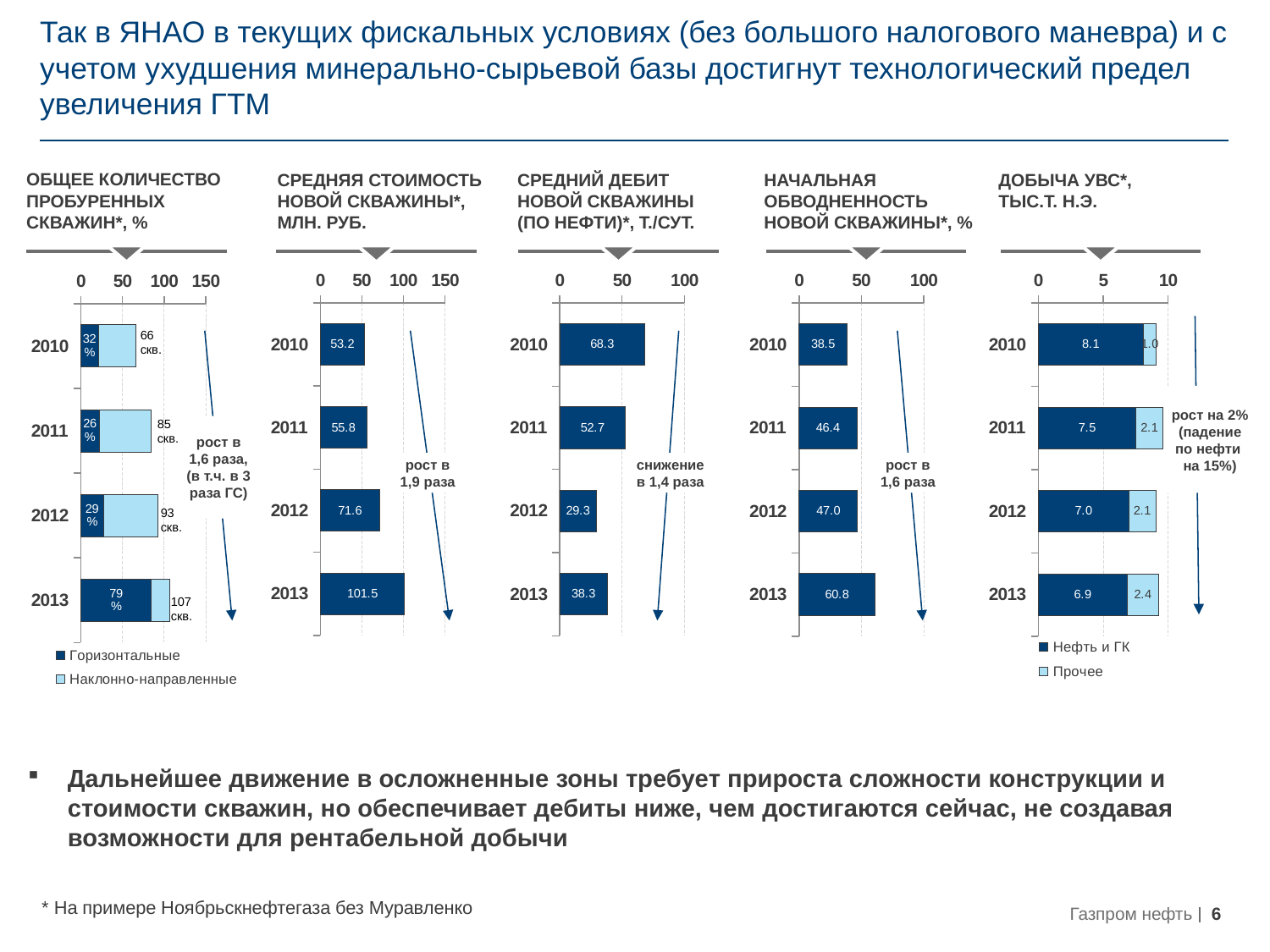
On the chart 'НАЧАЛЬНАЯ ОБВОДНЕННОСТЬ НОВОЙ СКВАЖИНЫ*, %', which year has the highest value? 2013 On the chart 'СРЕДНЯЯ СТОИМОСТЬ НОВОЙ СКВАЖИНЫ*, МЛН. РУБ.', what is the value for 2013? 101.5 What type of chart is 'СРЕДНЯЯ СТОИМОСТЬ НОВОЙ СКВАЖИНЫ*, МЛН. РУБ.'? bar chart On the chart 'СРЕДНИЙ ДЕБИТ НОВОЙ СКВАЖИНЫ (ПО НЕФТИ)*, Т./СУТ.', is the value for 2010 larger or smaller than the value for 2011? larger On the chart 'ДОБЫЧА УВС*, ТЫС.Т. Н.Э.', what is the total of the stacked bar for 2013? 9.3 How many years are shown on the chart 'ДОБЫЧА УВС*, ТЫС.Т. Н.Э.'? 4 How many series does the legend of the chart 'ОБЩЕЕ КОЛИЧЕСТВО ПРОБУРЕННЫХ СКВАЖИН*, %' list? 2 On the chart 'СРЕДНЯЯ СТОИМОСТЬ НОВОЙ СКВАЖИНЫ*, МЛН. РУБ.', what is the difference between the 2013 and 2010 values? 48.3 On the chart 'ДОБЫЧА УВС*, ТЫС.Т. Н.Э.', what is the value of 'Прочее' for 2011? 2.1 On the chart 'СРЕДНИЙ ДЕБИТ НОВОЙ СКВАЖИНЫ (ПО НЕФТИ)*, Т./СУТ.', which year has the lowest value? 2012 On the chart 'СРЕДНЯЯ СТОИМОСТЬ НОВОЙ СКВАЖИНЫ*, МЛН. РУБ.', do the values rise or fall from 2010 to 2013? rise On the chart 'НАЧАЛЬНАЯ ОБВОДНЕННОСТЬ НОВОЙ СКВАЖИНЫ*, %', is the value for 2013 greater or less than 50? greater